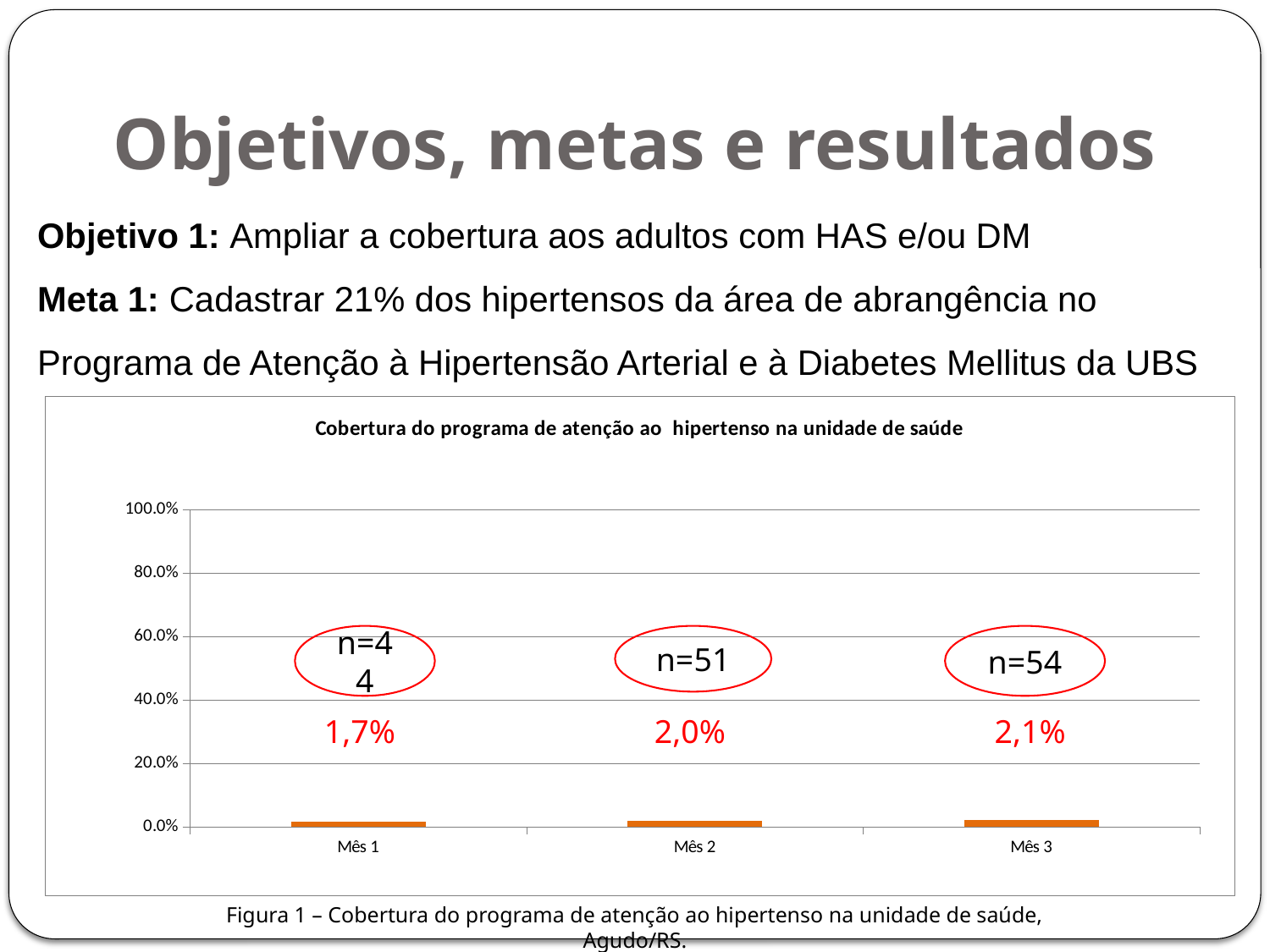
What is the coverage value labelled for Mês 2? 2,0% What is the coverage value labelled for Mês 3? 2,1% Do the coverage values rise or fall from Mês 1 to Mês 3? rise How many months (categories) are shown on the x axis of the chart? 3 What is the n value shown for Mês 2? n=51 What is the difference between the coverage values for Mês 3 and Mês 1? 0,4% What is the n value shown for Mês 3? n=54 Which month has the highest coverage value? Mês 3 What is the title of the chart? Cobertura do programa de atenção ao hipertenso na unidade de saúde What is the coverage value labelled for Mês 1? 1,7% Which month has the lowest coverage value? Mês 1 What type of chart is shown on the slide? bar chart